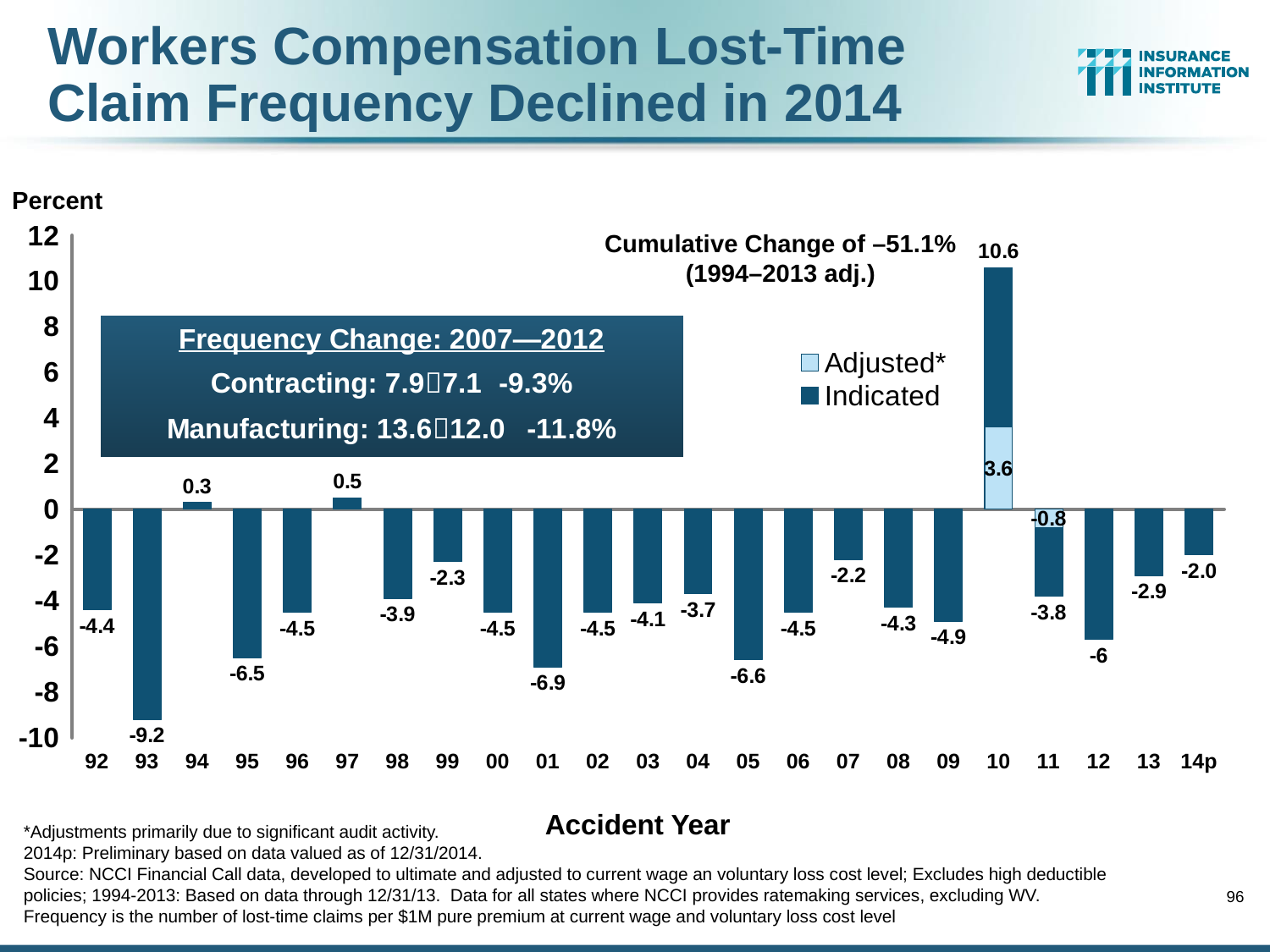
What kind of chart is shown on the slide? Bar chart What is the label on the x axis? Accident Year What is the value for accident year 93? -9.2 How many accident years are shown on the x axis? 23 Which accident year has the lowest value? 93 Which accident year has a larger value, 94 or 97? 97 What is the value for accident year 14p? -2.0 What is the Adjusted value for accident year 10? 3.6 What is the Indicated value for accident year 10? 10.6 Which accident year has the highest value? 10 What is the difference between the values for accident years 12 and 13? 3.1 How many series does the legend list? 2